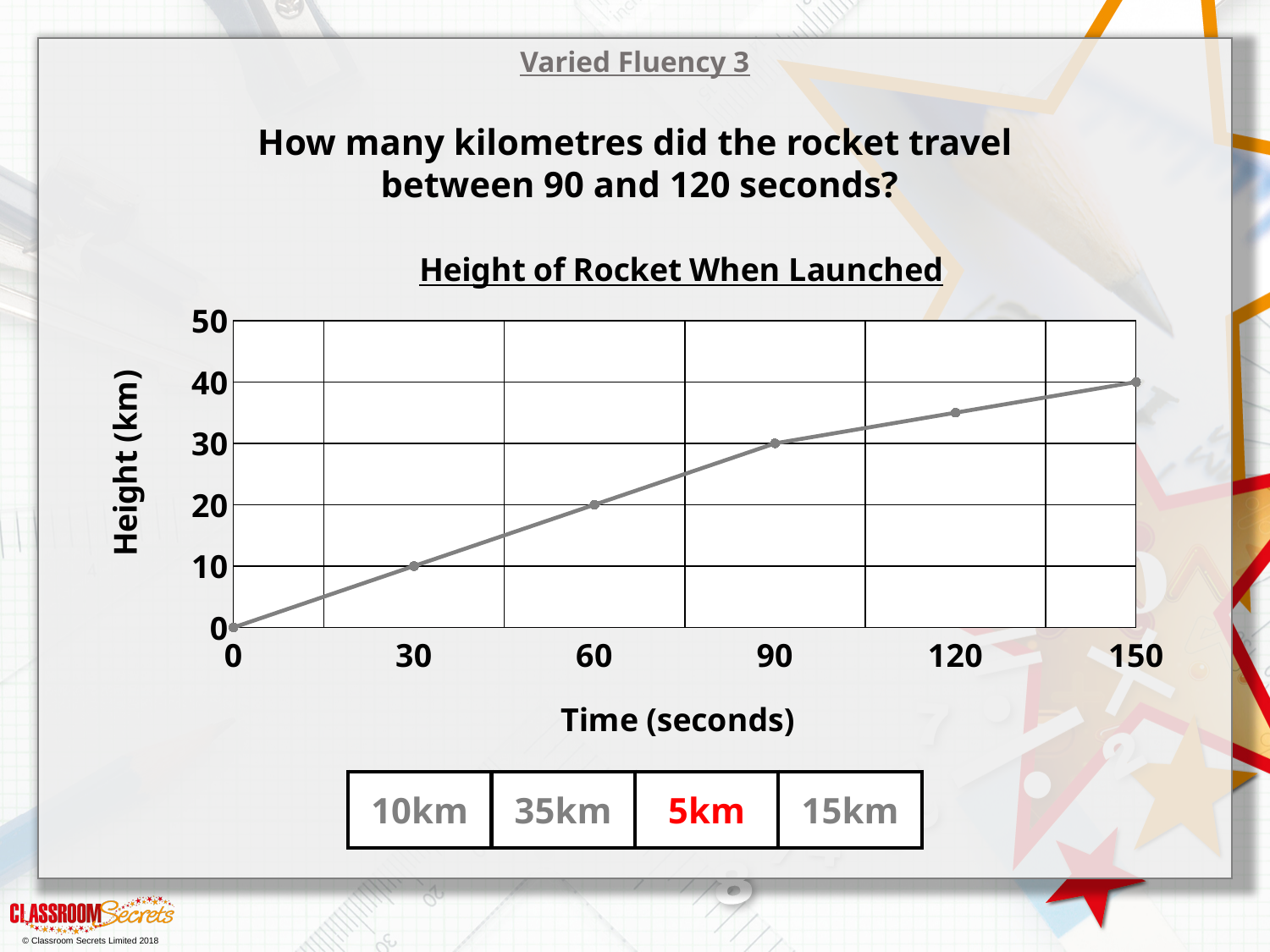
What is the height of the rocket at 90 seconds? 30 How many data points are plotted on the line? 6 At which time shown on the x axis is the rocket's height greatest? 150 By how many kilometres does the height increase between 60 and 90 seconds? 10 What is the height of the rocket at 60 seconds? 20 What is the height of the rocket at 30 seconds? 10 Is the height of the rocket at 120 seconds greater or less than 30? greater What is the height of the rocket at 150 seconds? 40 Does the height of the rocket rise or fall as time increases along the x axis? rise What kind of chart is shown on the slide? line chart By how many kilometres does the height increase between 30 and 150 seconds? 30 What is the title of the chart? Height of Rocket When Launched